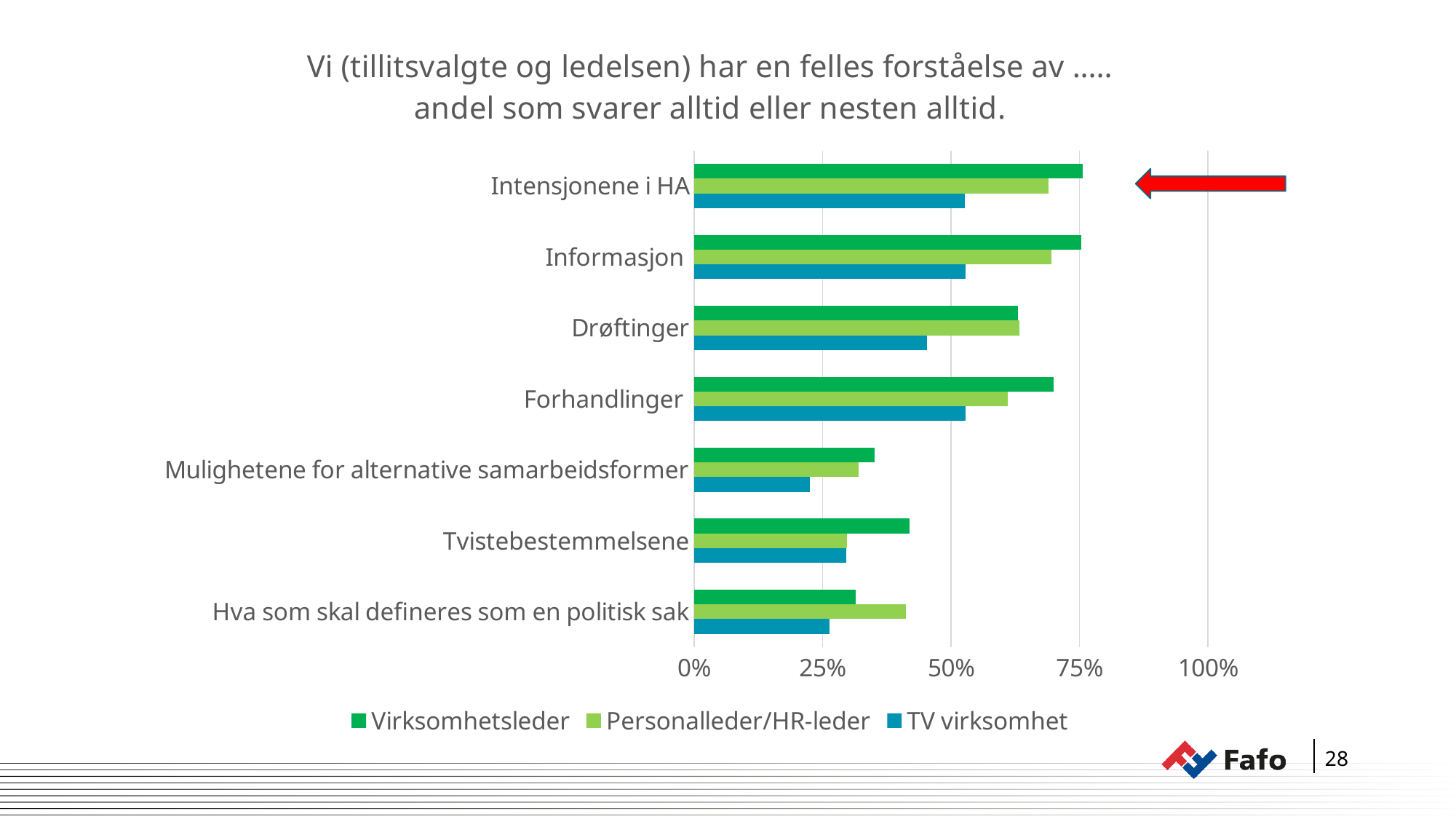
In the category Tvistebestemmelsene, which is larger: Virksomhetsleder or TV virksomhet? Virksomhetsleder What colour are the bars for the series TV virksomhet? blue Is the value for Personalleder/HR-leder in the category Tvistebestemmelsene greater or less than 50%? less What are the three series listed in the legend? Virksomhetsleder, Personalleder/HR-leder, TV virksomhet How many categories are shown on the chart? 7 In the category Forhandlinger, which is larger: Virksomhetsleder or Personalleder/HR-leder? Virksomhetsleder Is the value for Virksomhetsleder in the category Forhandlinger greater or less than 50%? greater How many series does the legend list? 3 What kind of chart is shown on the slide? bar chart Is the value for Virksomhetsleder in the category Intensjonene i HA greater or less than 50%? greater In the category Hva som skal defineres som en politisk sak, which is larger: Virksomhetsleder or Personalleder/HR-leder? Personalleder/HR-leder